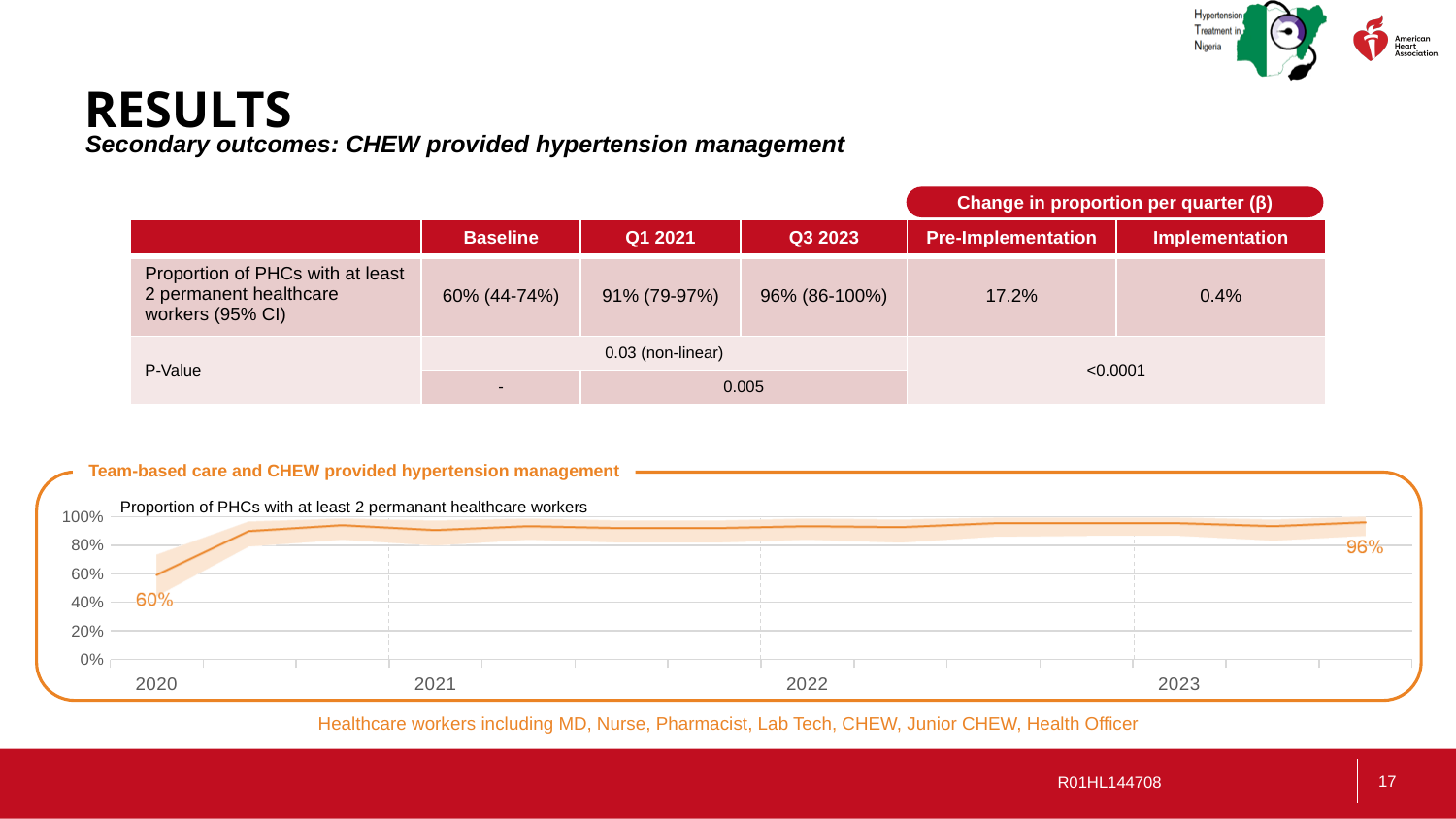
Is the labelled starting value in 2020 greater or less than 80%? less What is the title printed above the line chart? Proportion of PHCs with at least 2 permanant healthcare workers Is the value of the line at the start of 2021 greater or less than 80%? greater What is the labelled value at the end of the line in 2023? 96% Which is larger, the labelled value at the start of the line in 2020 or at the end in 2023? 2023 What is the highest value shown on the y axis of the chart? 100% What is the difference between the labelled end value (96%) and the labelled start value (60%)? 36 percentage points Is the value of the line at the start of 2022 greater or less than 60%? greater How many year labels are shown on the x axis of the chart? 4 What is the labelled value at the start of the line in 2020? 60% Does the proportion of PHCs with at least 2 permanent healthcare workers rise or fall from 2020 to 2023? Rise What kind of chart is shown on the slide? Line chart